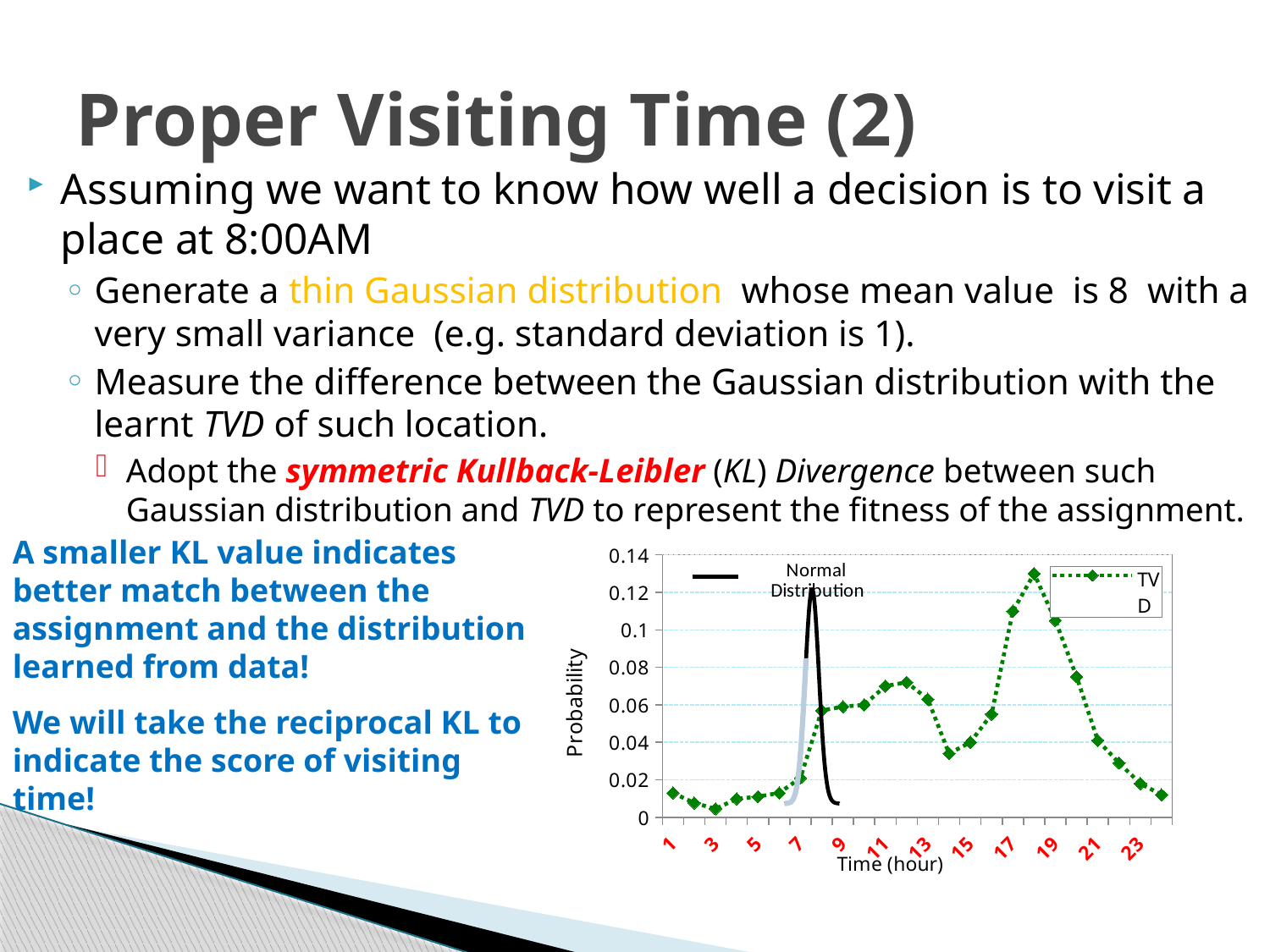
Does the TVD series rise or fall from hour 19 to hour 23? fall Is the TVD value at hour 3 greater or less than 0.02? less Is the TVD value at hour 13 greater or less than 0.04? greater What is the label of the chart's x axis? Time (hour) Is the peak of the Normal Distribution curve greater or less than 0.1? greater How many tick labels are shown on the chart's x axis? 12 What kind of chart is shown on the slide? line chart How many series does the chart's legend list? 2 Which is larger, the TVD value at hour 17 or the TVD value at hour 3? hour 17 What are the two series named in the chart's legend? Normal Distribution and TVD